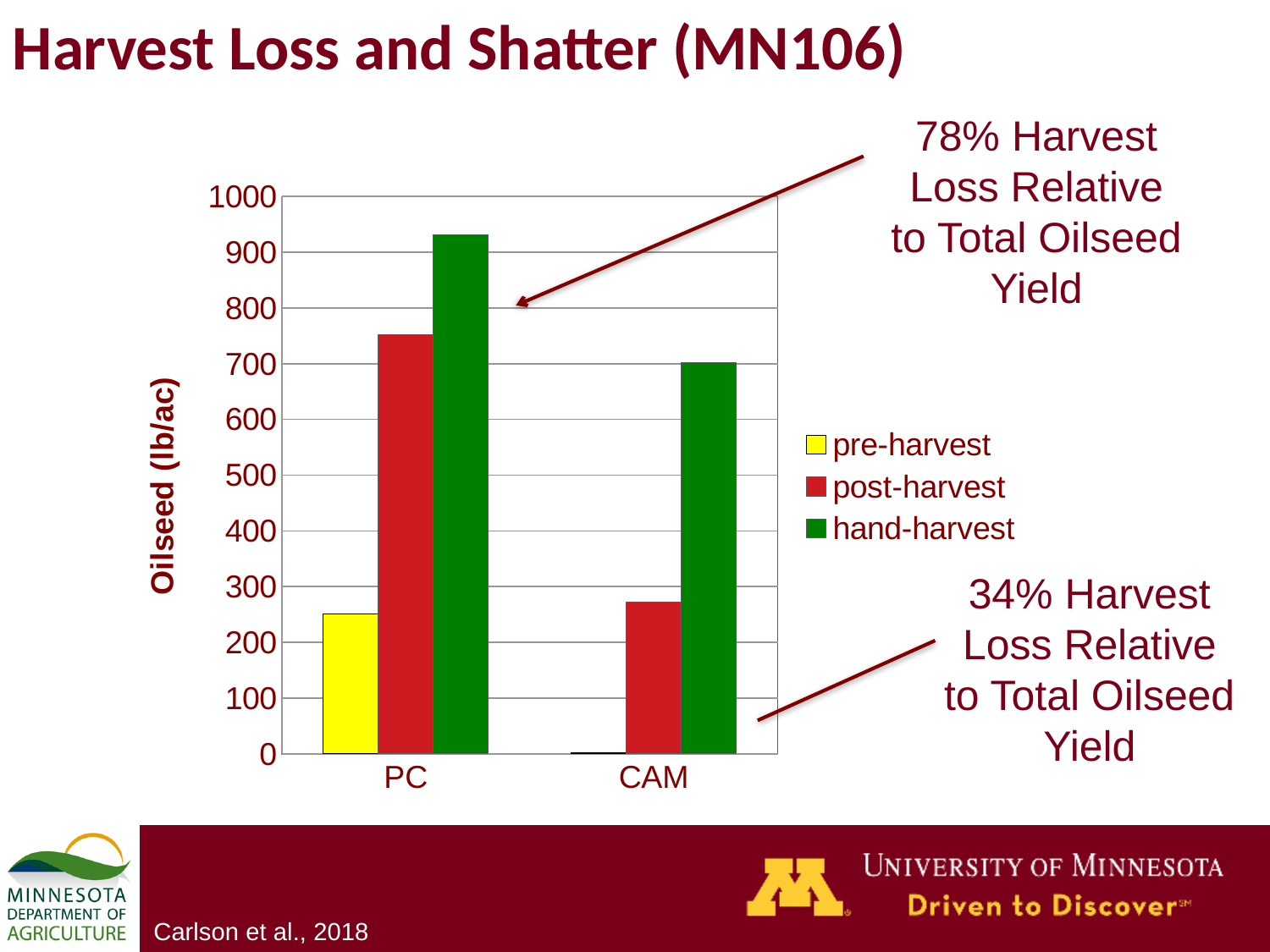
How many categories are shown on the x axis? 2 Is the hand-harvest value for CAM greater or less than 800? less Is the post-harvest value for CAM greater or less than 300? less Which series has the lowest value for CAM? pre-harvest Which is larger, the post-harvest value for PC or the post-harvest value for CAM? PC What is the label of the y axis? Oilseed (lb/ac) Is the pre-harvest value for PC greater or less than 200? greater Which series has the highest value for PC? hand-harvest What colour represents the hand-harvest series? green How many series does the legend list? 3 What kind of chart is shown on the slide? bar chart